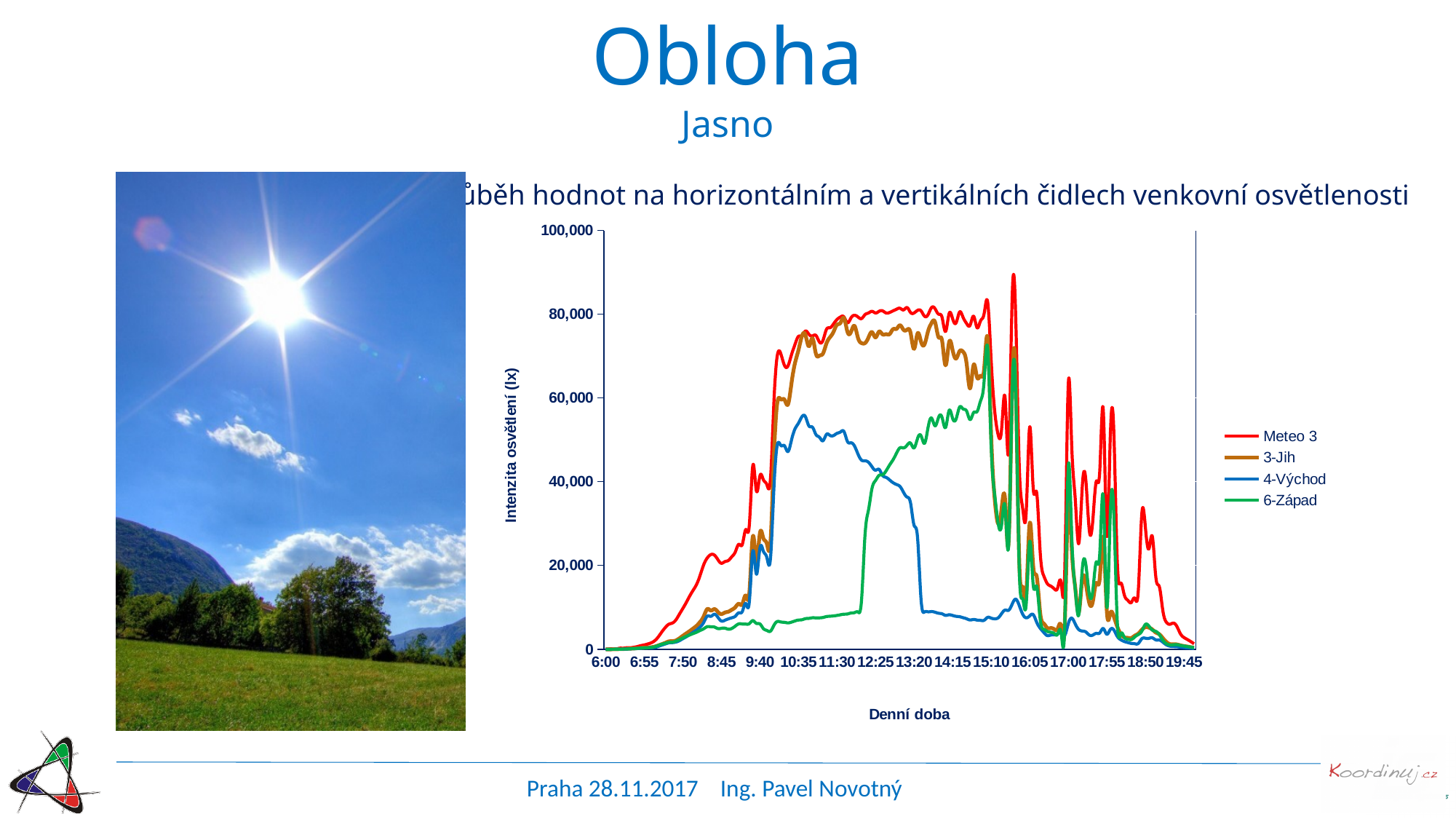
Is the value for 4-Východ at 14:15 greater or less than 20,000? less Is the value for Meteo 3 at 12:25 greater or less than 60,000? greater Is the value for 6-Západ at 10:35 greater or less than 20,000? less Between 12:25 and 13:20, does the 4-Východ series rise or fall? fall What is the label of the vertical axis? Intenzita osvětlení (lx) What are the series names listed in the legend? Meteo 3, 3-Jih, 4-Východ, 6-Západ Which series reaches the highest peak value on the chart? Meteo 3 At 14:15, which series has the higher value, 6-Západ or 4-Východ? 6-Západ At 10:35, which series has the higher value, 4-Východ or 6-Západ? 4-Východ How many series does the legend list? 4 What kind of chart is shown on the slide? line chart